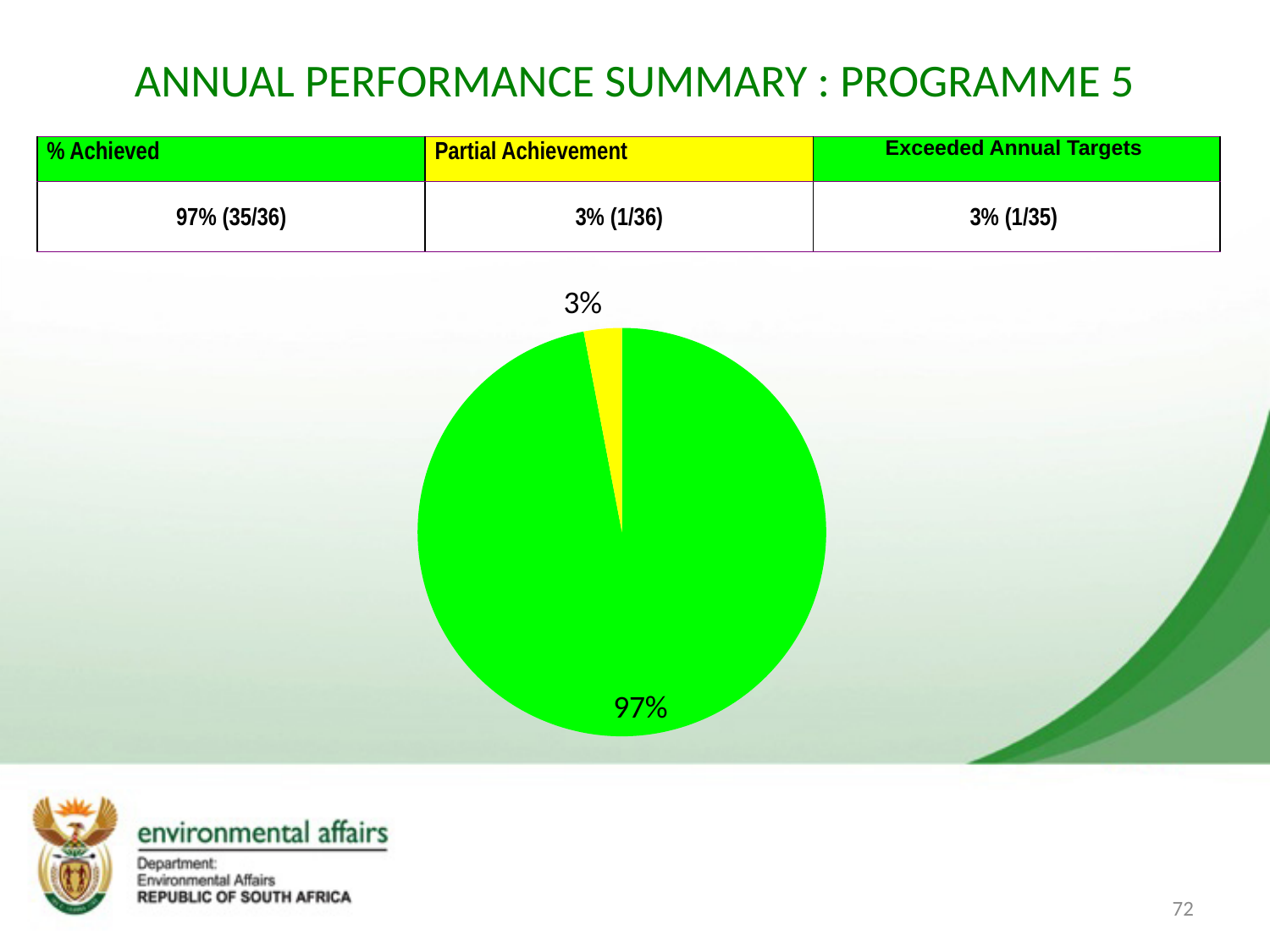
Which slice of the pie chart is the largest? The green slice (97%) According to the table above the pie chart, what fraction corresponds to the 97% achieved value? 35/36 What percentage is shown on the large green slice of the pie chart? 97% What is the difference in percentage points between the green slice and the yellow slice of the pie chart? 94 What share of the pie does the yellow slice represent? 3% How many slices does the pie chart have? 2 What colour is the slice labelled 97% in the pie chart? Green What percentage is shown on the small yellow slice of the pie chart? 3% Which slice of the pie chart is the smallest? The yellow slice (3%) Is the green slice or the yellow slice of the pie chart larger? The green slice What kind of chart is shown on the slide? Pie chart